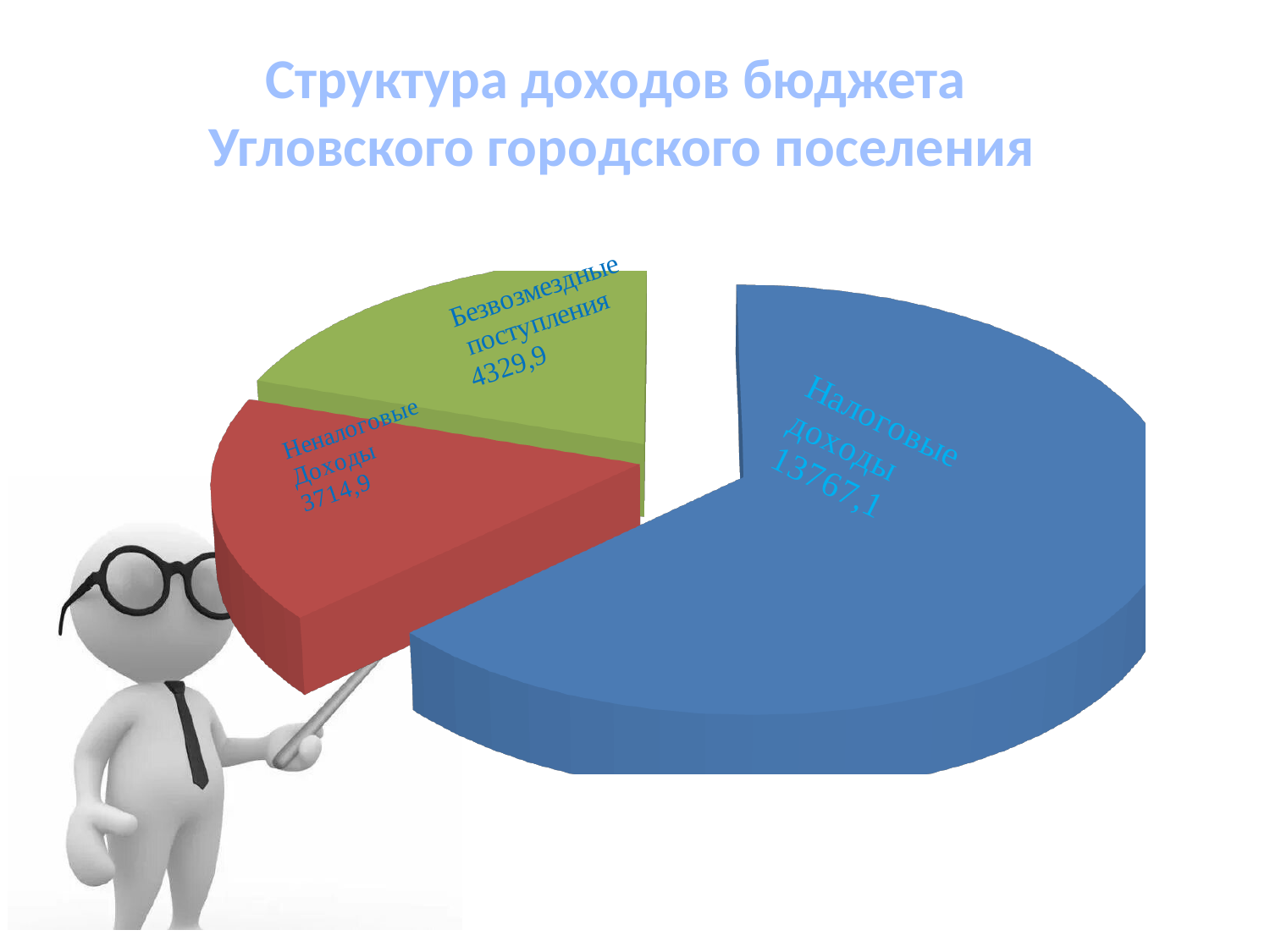
What is the total of all three slices of the pie? 21811,9 How many slices does the pie chart have? 3 Which is larger, Безвозмездные поступления or Неналоговые доходы? Безвозмездные поступления What is the value for Налоговые доходы? 13767,1 What is the value for Безвозмездные поступления? 4329,9 Which category has the smallest slice of the pie? Неналоговые доходы Which category has the largest slice of the pie? Налоговые доходы What is the difference between Налоговые доходы and Неналоговые доходы? 10052,2 What colour is the slice for Налоговые доходы? blue What type of chart is shown on the slide? pie chart What is the difference between Безвозмездные поступления and Неналоговые доходы? 615,0 What is the value for Неналоговые доходы? 3714,9